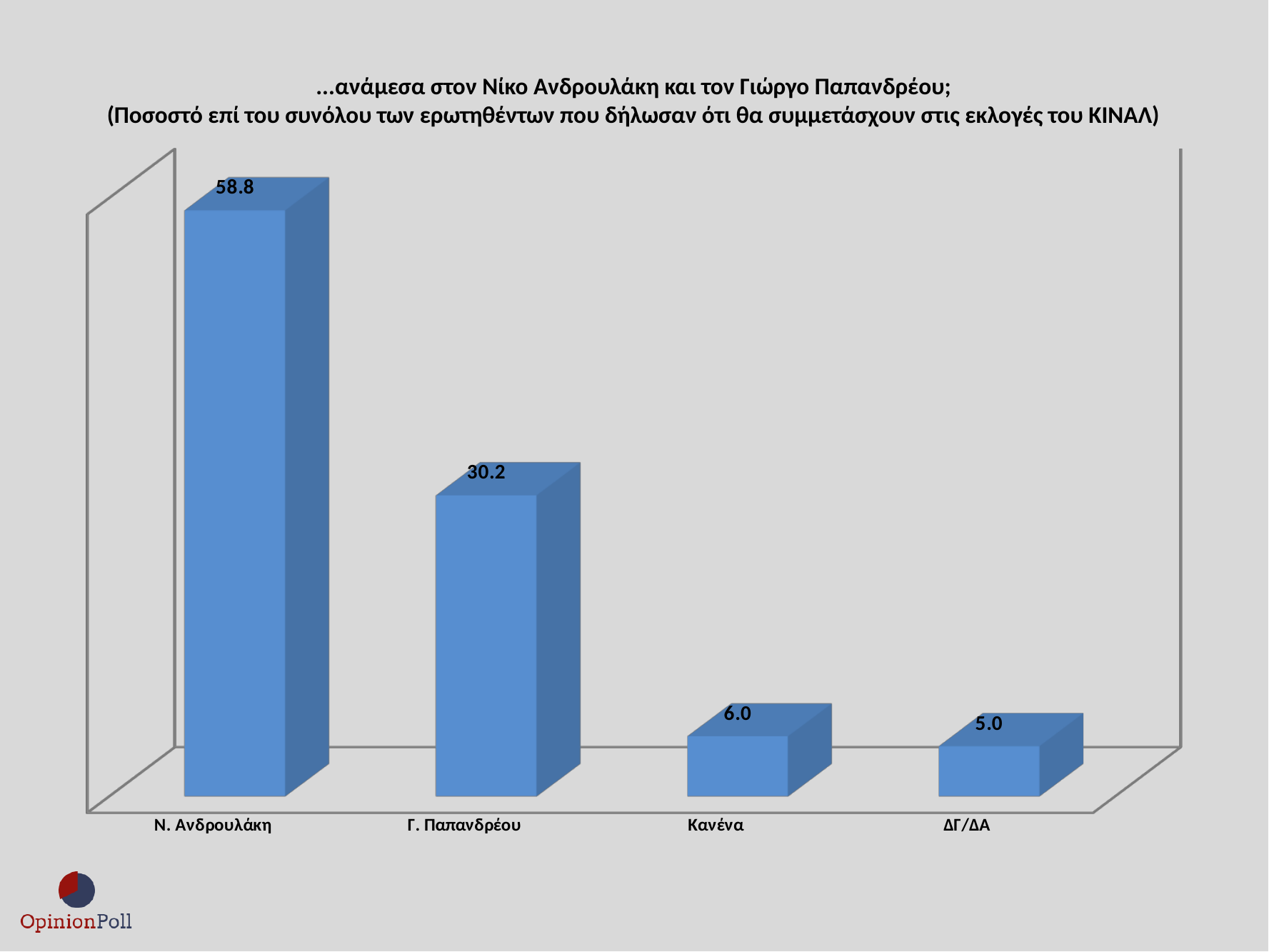
What kind of chart is this? bar chart What is the value for Ν. Ανδρουλάκη? 58.8 What is the value for Γ. Παπανδρέου? 30.2 What is the difference between the values for Κανένα and ΔΓ/ΔΑ? 1.0 Which category has the highest value? Ν. Ανδρουλάκη What is the value for Κανένα? 6.0 What is the difference between the values for Ν. Ανδρουλάκη and Γ. Παπανδρέου? 28.6 Which is larger, the value for Γ. Παπανδρέου or the value for Κανένα? Γ. Παπανδρέου Do the values rise or fall from left to right along the x axis? fall Which category has the lowest value? ΔΓ/ΔΑ How many categories are shown on the x axis? 4 What is the value for ΔΓ/ΔΑ? 5.0